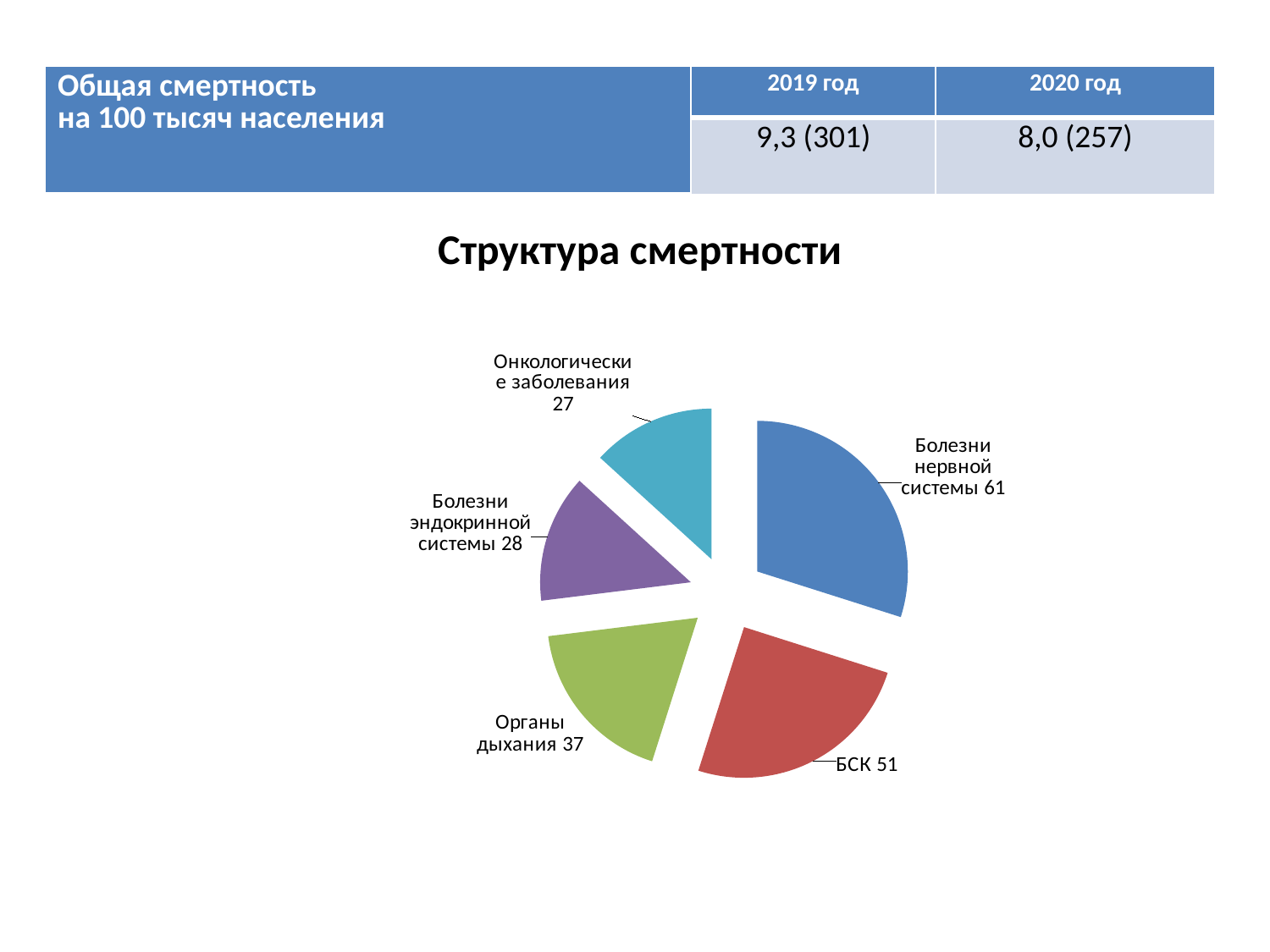
What kind of chart is shown under the title "Структура смертности"? Pie chart What is the difference between the values for "Болезни нервной системы" and "БСК"? 10 Which category has the smallest slice in the pie chart? Онкологические заболевания Which is larger in the pie chart: "Органы дыхания" or "Болезни эндокринной системы"? Органы дыхания What is the value for "БСК" in the pie chart? 51 What is the value for "Онкологические заболевания" in the pie chart? 27 What is the title of the pie chart? Структура смертности How many slices does the pie chart have? 5 What is the value for "Болезни эндокринной системы" in the pie chart? 28 What is the value for "Органы дыхания" in the pie chart? 37 What is the value for "Болезни нервной системы" in the pie chart? 61 Which category has the largest slice in the pie chart? Болезни нервной системы